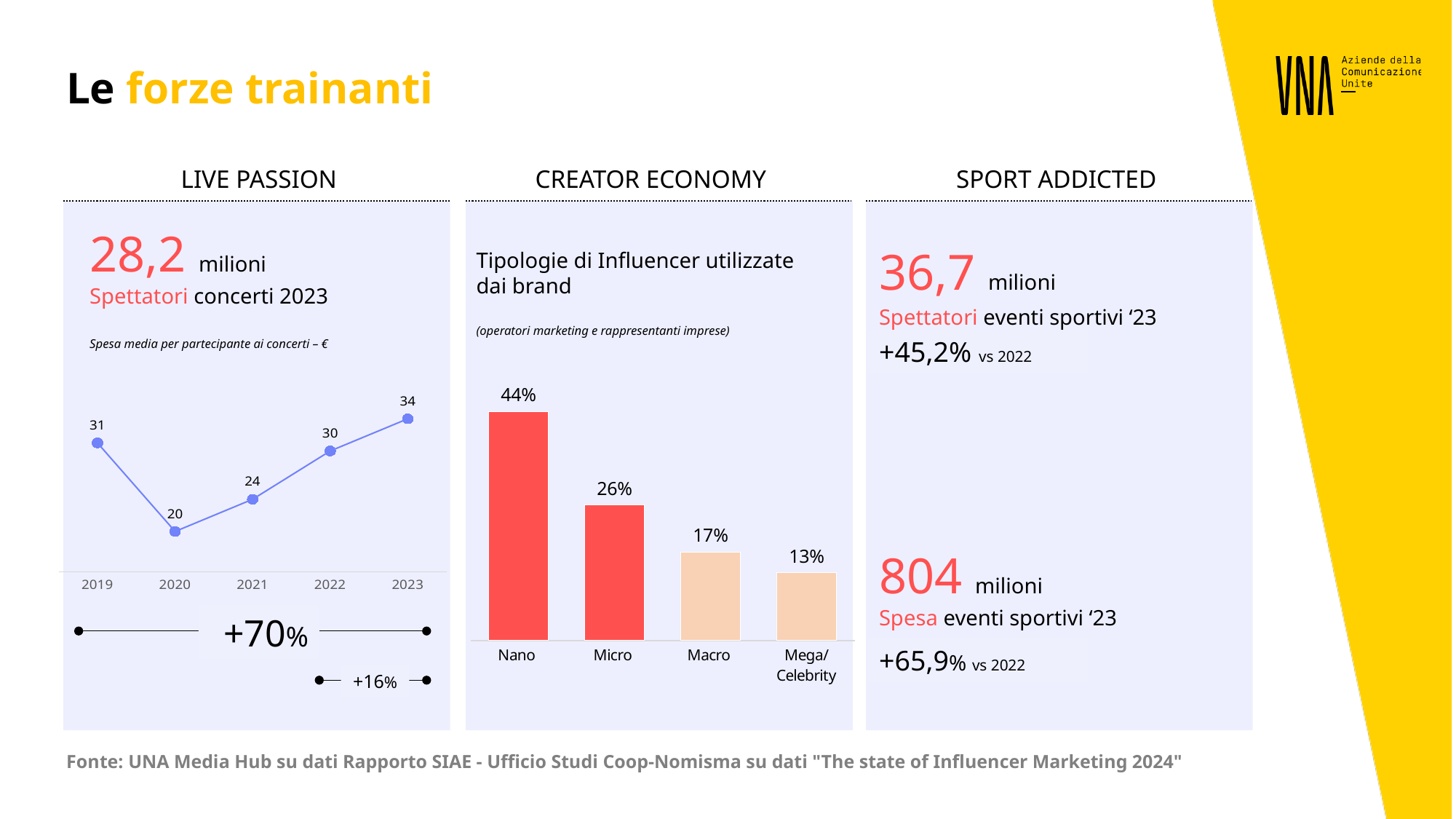
In the line chart under LIVE PASSION (Spesa media per partecipante ai concerti), what is the value for 2020? 20 In the line chart under LIVE PASSION, which year has the lowest value? 2020 In the bar chart under CREATOR ECONOMY, which category has the highest value? Nano In the bar chart under CREATOR ECONOMY, what is the difference between Nano and Mega/Celebrity? 31% In the bar chart under CREATOR ECONOMY, what is the value for Micro? 26% In the line chart under LIVE PASSION, what is the difference between the 2023 value and the 2020 value? 14 In the bar chart under CREATOR ECONOMY, which is larger, Macro or Mega/Celebrity? Macro In the line chart under LIVE PASSION, do the values rise or fall from 2020 to 2023? rise In the line chart under LIVE PASSION, what is the value for 2023? 34 In the line chart under LIVE PASSION, how many years are plotted? 5 In the line chart under LIVE PASSION, which year has the highest value? 2023 What kind of chart is shown under CREATOR ECONOMY (Tipologie di Influencer utilizzate dai brand)? bar chart